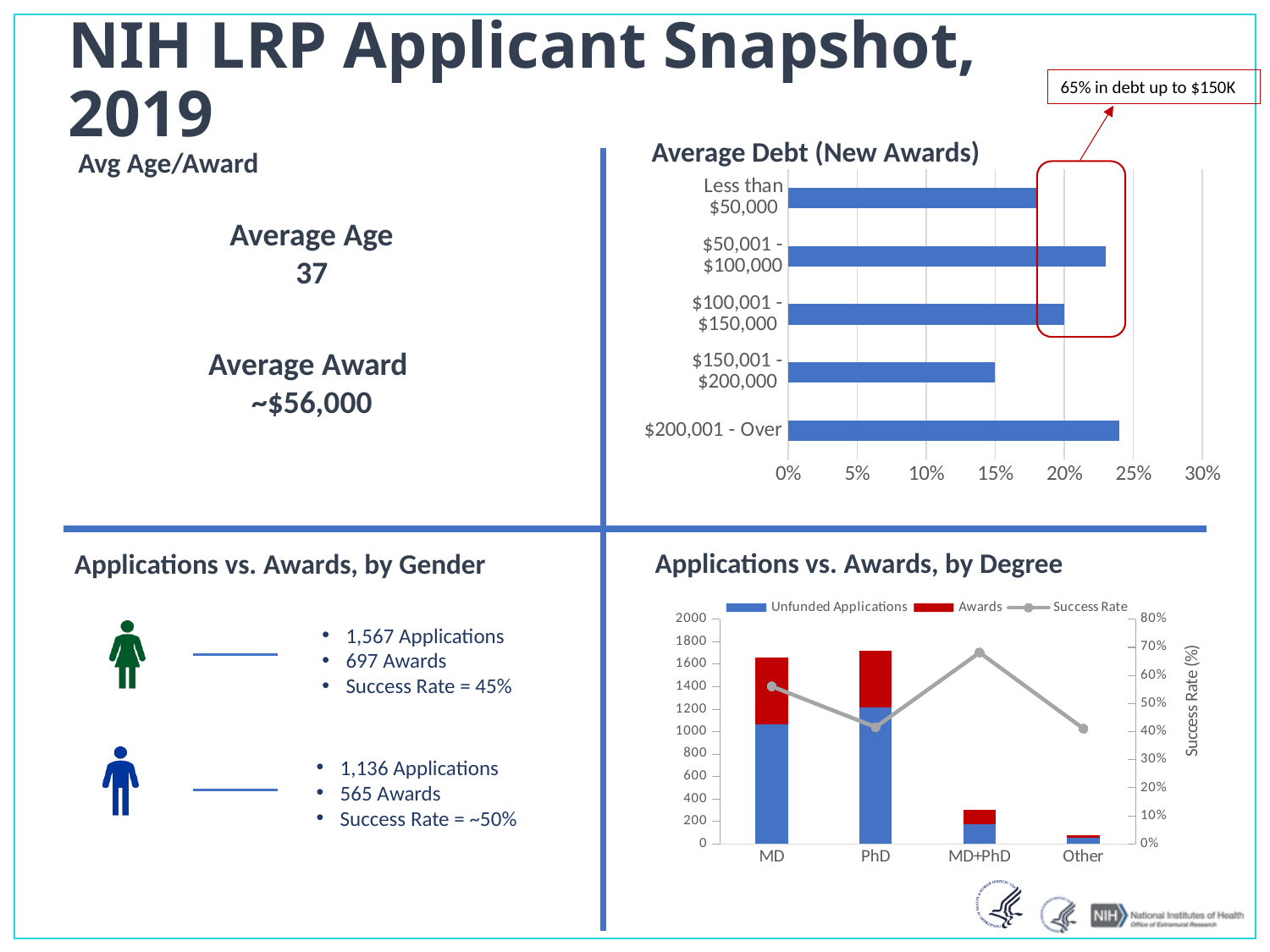
In the "Average Debt (New Awards)" chart, which is larger: the value for "$100,001 - $150,000" or the value for "$150,001 - $200,000"? $100,001 - $150,000 In the "Applications vs. Awards, by Degree" chart, is the success rate for MD+PhD greater or less than 60%? greater In the "Applications vs. Awards, by Degree" chart, which degree has the highest success rate? MD+PhD In the "Average Debt (New Awards)" chart, is the value for "Less than $50,000" greater or less than 15%? greater In the "Applications vs. Awards, by Degree" chart, is the total stacked bar for PhD greater or less than 1600? greater What kind of chart is the "Average Debt (New Awards)" chart? bar chart How many series does the legend of the "Applications vs. Awards, by Degree" chart list? 3 How many debt categories are shown in the "Average Debt (New Awards)" chart? 5 In the "Average Debt (New Awards)" chart, which debt category has the lowest share? $150,001 - $200,000 In the "Applications vs. Awards, by Degree" chart, what colour represents the Awards series? red How many degree categories are shown on the x axis of the "Applications vs. Awards, by Degree" chart? 4